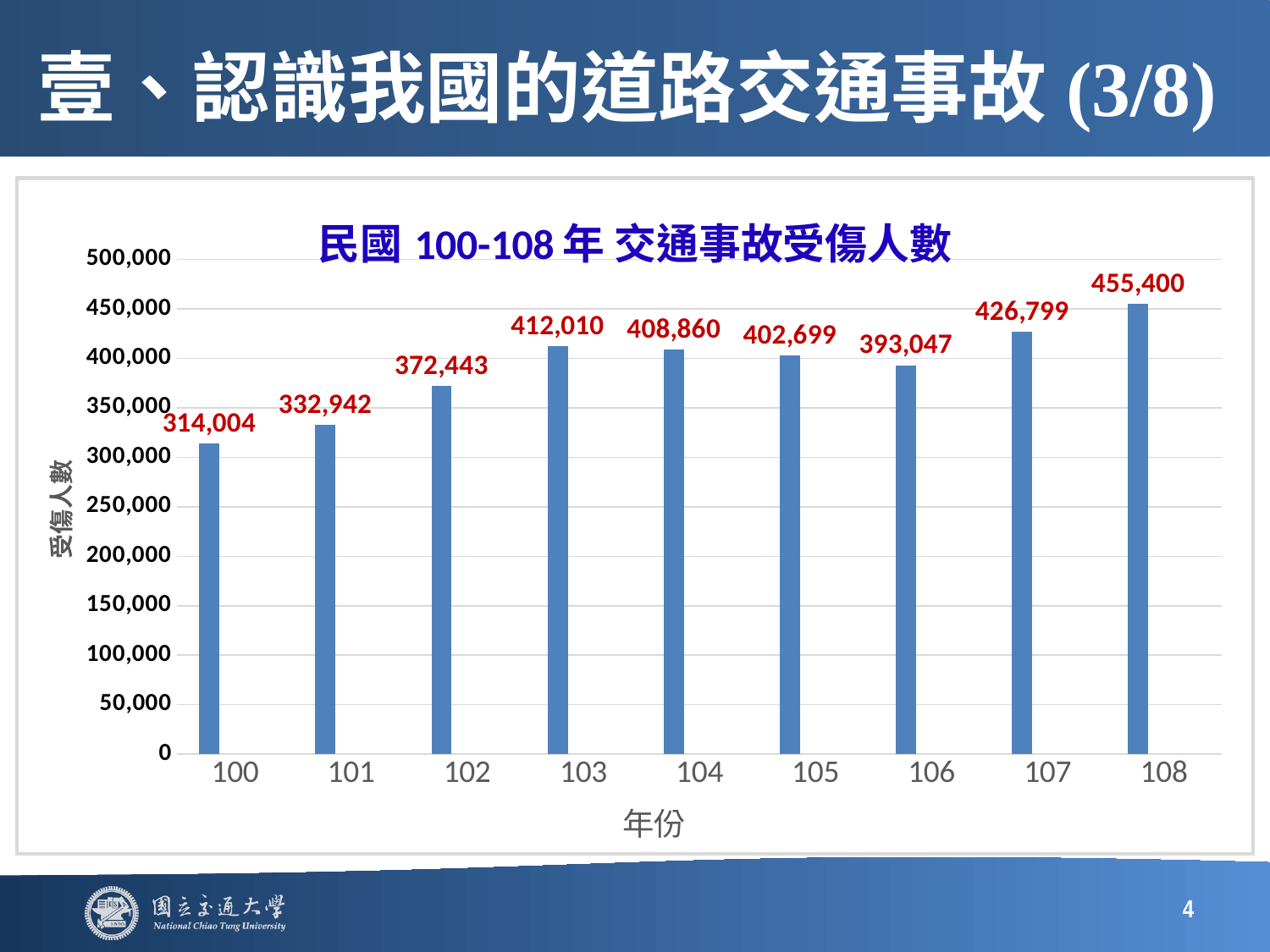
What is the difference between the values for year 108 and year 107? 28,601 What is the number of injured persons for year 103? 412,010 Which year has the highest number of injured persons? 108 What is the difference between the values for year 101 and year 100? 18,938 Is the value for year 102 greater or less than 350,000? greater What is the title of the chart? 民國 100-108 年 交通事故受傷人數 Which is larger, the value for year 104 or the value for year 105? 104 What is the number of injured persons for year 100? 314,004 What kind of chart is shown on the slide? bar chart How many years are shown on the x axis? 9 What is the number of injured persons for year 106? 393,047 Which year has the lowest number of injured persons? 100